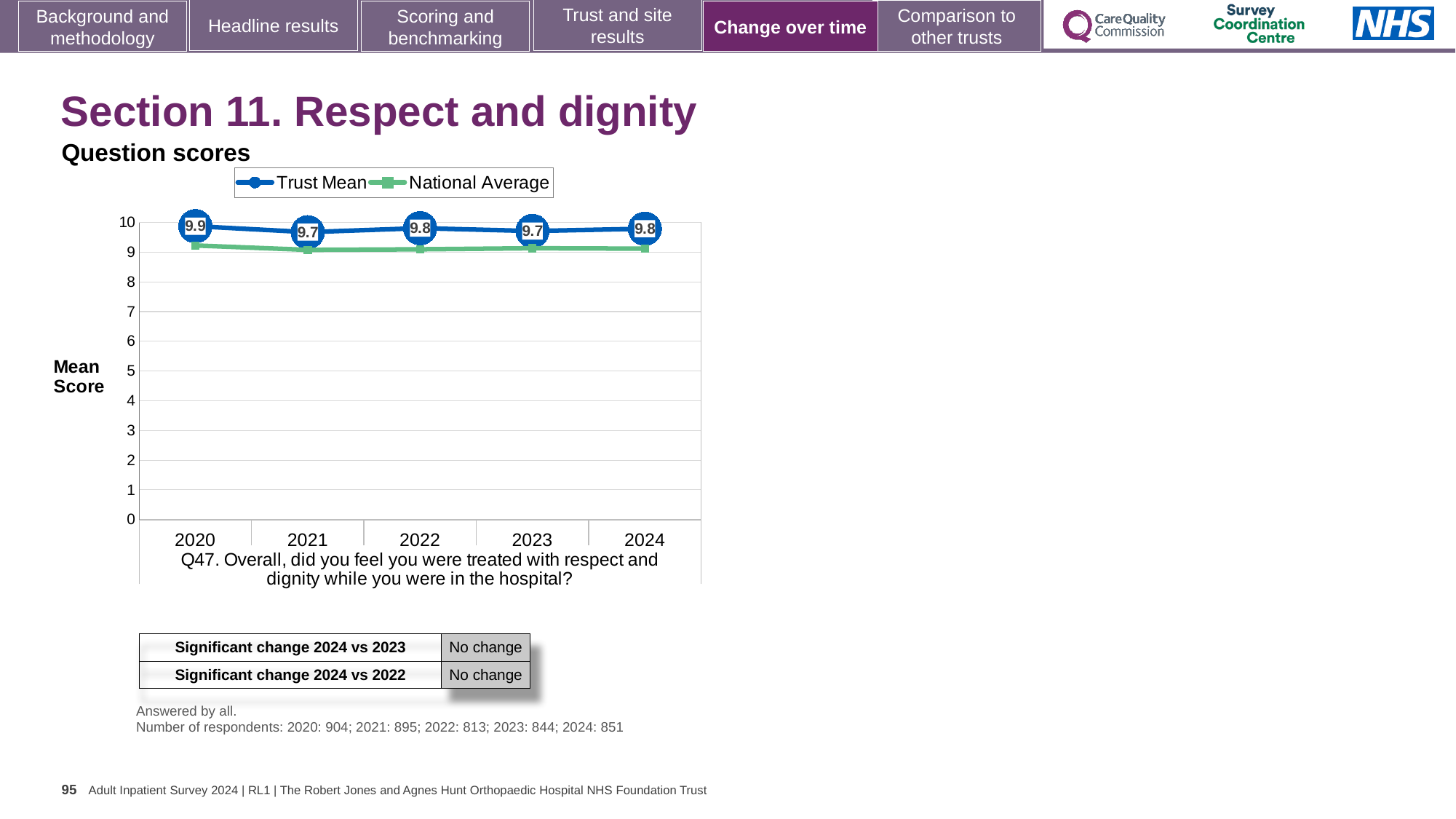
What is the Trust Mean score for 2020? 9.9 What is the Trust Mean score for 2023? 9.7 What is the Trust Mean score for 2022? 9.8 Is the National Average for 2024 greater or less than 8? greater How many series does the legend list? 2 What is the label on the y axis? Mean Score Is the National Average for 2021 greater or less than 10? less Is the Trust Mean for 2021 higher or lower than the Trust Mean for 2020? lower What is the difference between the Trust Mean in 2020 and in 2021? 0.2 What kind of chart is shown? line chart How many years are shown on the x axis? 5 In which year is the Trust Mean highest? 2020